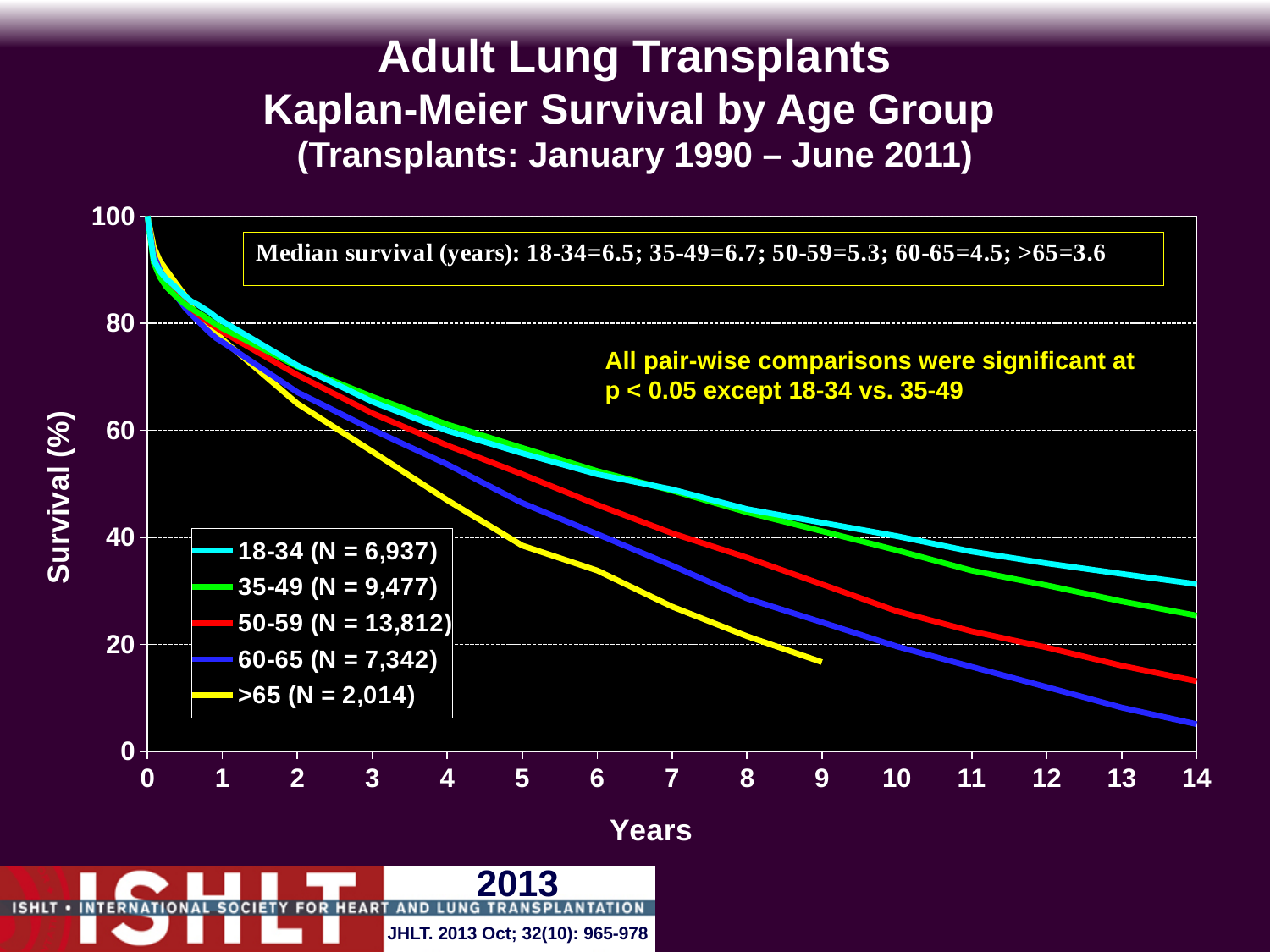
How many age groups (series) does the legend list? 5 What kind of chart is shown on the slide? line chart Is the survival value for the 60-65 group at 14 years greater or less than 20? less What is the difference in median survival (years) between the 35-49 group and the >65 group? 3.1 At 10 years, which group has higher survival: 35-49 or 60-65? 35-49 Is the survival value for the 18-34 group at 14 years greater or less than 20? greater What is the N for the 50-59 age group shown in the legend? 13,812 What is the median survival in years for the >65 age group? 3.6 Which age group has the lowest median survival? >65 Do the survival curves rise or fall as years increase? fall Which age group has the highest median survival? 35-49 What is the median survival in years for the 50-59 age group? 5.3